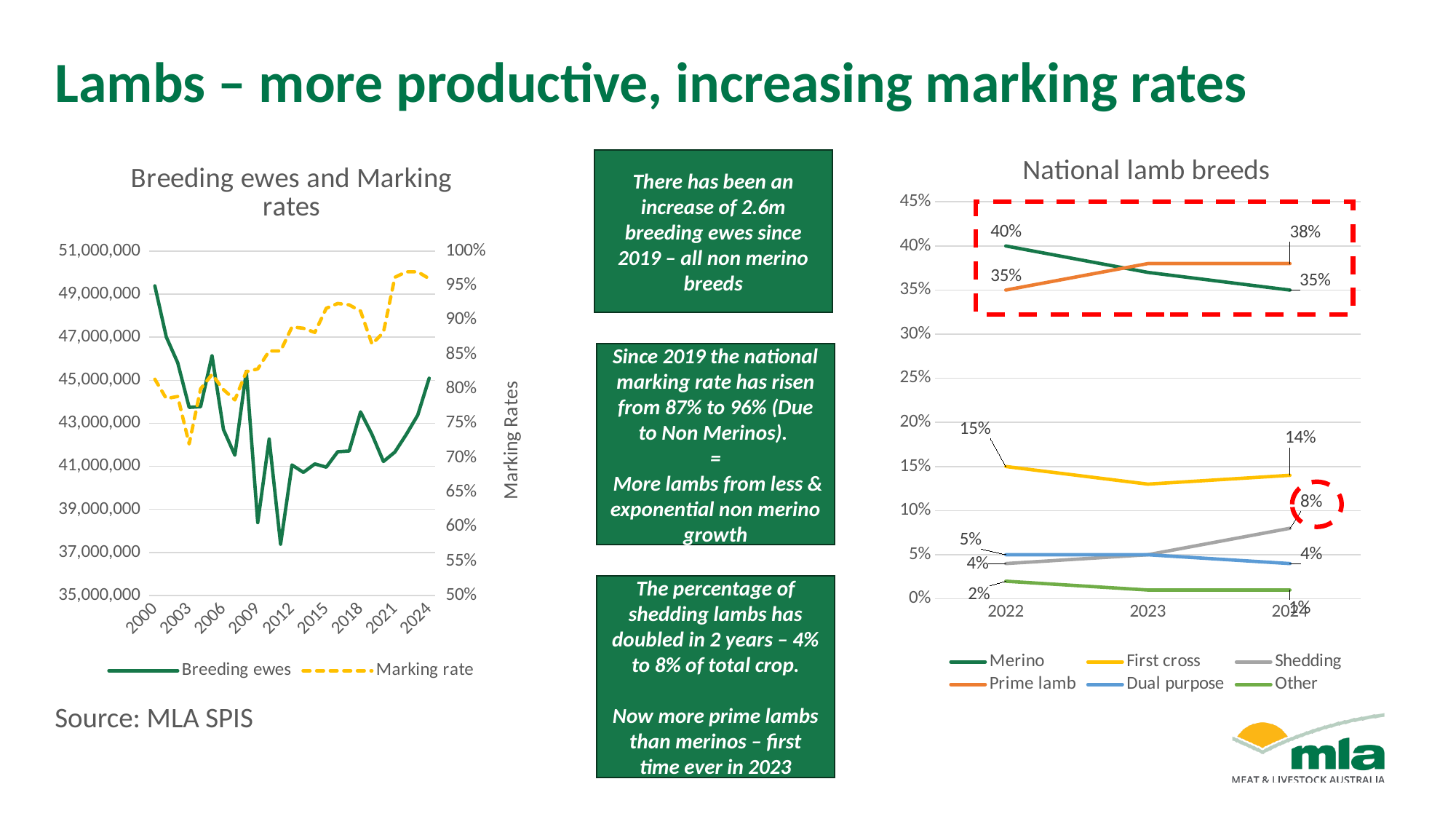
In the "National lamb breeds" chart, which breed has the highest share in 2022? Merino In the "National lamb breeds" chart, what is the value for Merino in 2022? 40% In the "National lamb breeds" chart, which is larger in 2024: Merino or Prime lamb? Prime lamb In the "National lamb breeds" chart, by how much did the Merino share fall from 2022 to 2024? 5% How many series does the legend of the "National lamb breeds" chart list? 6 In the "National lamb breeds" chart, what is the value for Shedding in 2024? 8% In the "Breeding ewes and Marking rates" chart, is the Marking rate in 2024 greater or less than 90%? greater In the "National lamb breeds" chart, does the Shedding line rise or fall from 2022 to 2024? rise In the "National lamb breeds" chart, what is the value for Prime lamb in 2024? 38% How many series does the legend of the "Breeding ewes and Marking rates" chart list? 2 What kind of chart is the "National lamb breeds" chart? line chart In the "National lamb breeds" chart, which breed has the lowest share in 2024? Other